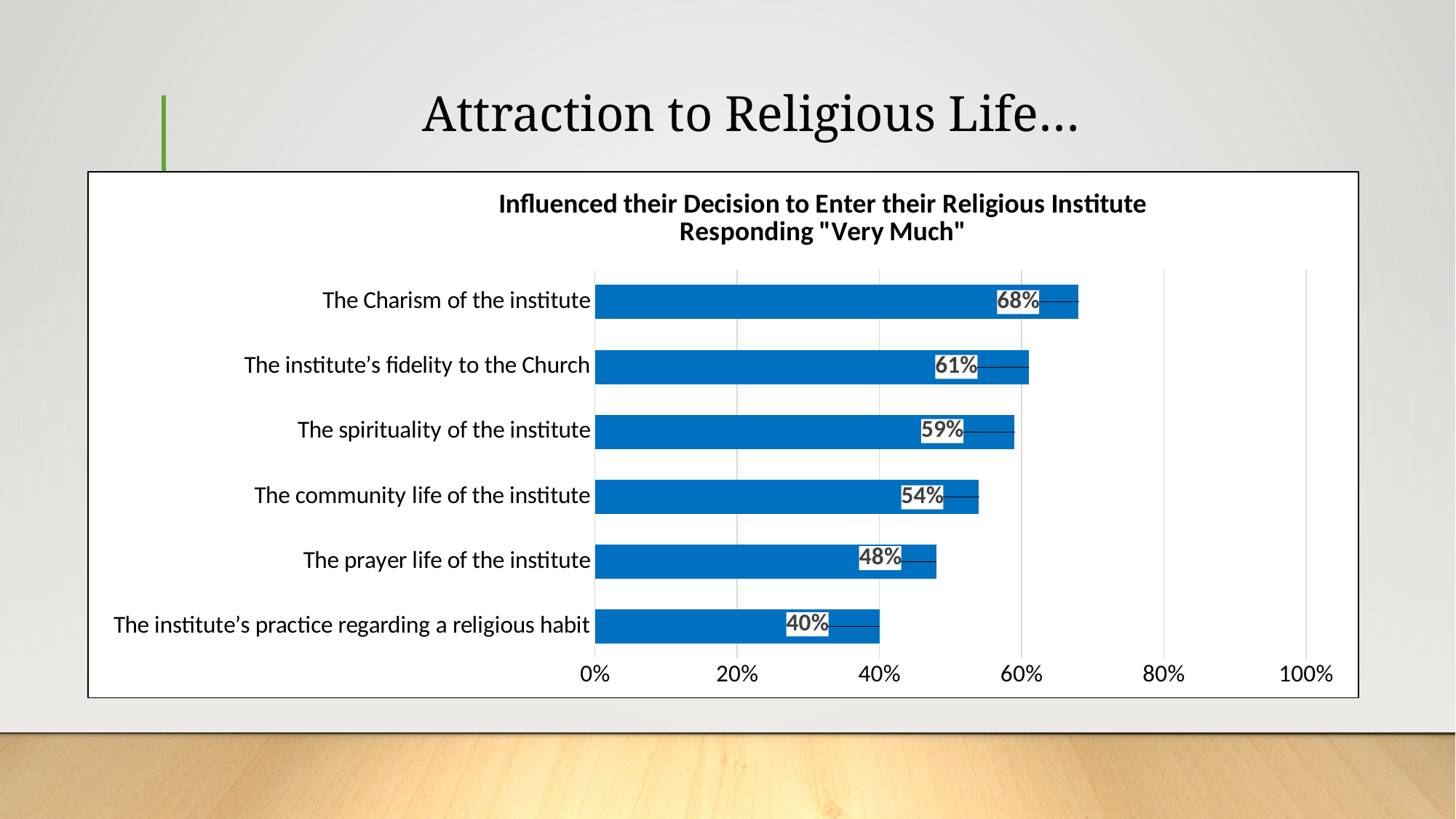
What is the value for The institute's practice regarding a religious habit? 40% Which category has the highest value? The Charism of the institute What kind of chart is shown on the slide? Bar chart What is the title of the chart? Influenced their Decision to Enter their Religious Institute Responding "Very Much" Is the value for The prayer life of the institute greater or less than 60%? less What is the difference between The Charism of the institute and The institute's practice regarding a religious habit? 28% What is the value for The prayer life of the institute? 48% Which is larger: The institute's fidelity to the Church or The spirituality of the institute? The institute's fidelity to the Church What percentage responded "Very Much" for The Charism of the institute? 68% What is the value for The community life of the institute? 54% Which category has the lowest value? The institute's practice regarding a religious habit How many categories are shown in the chart? 6